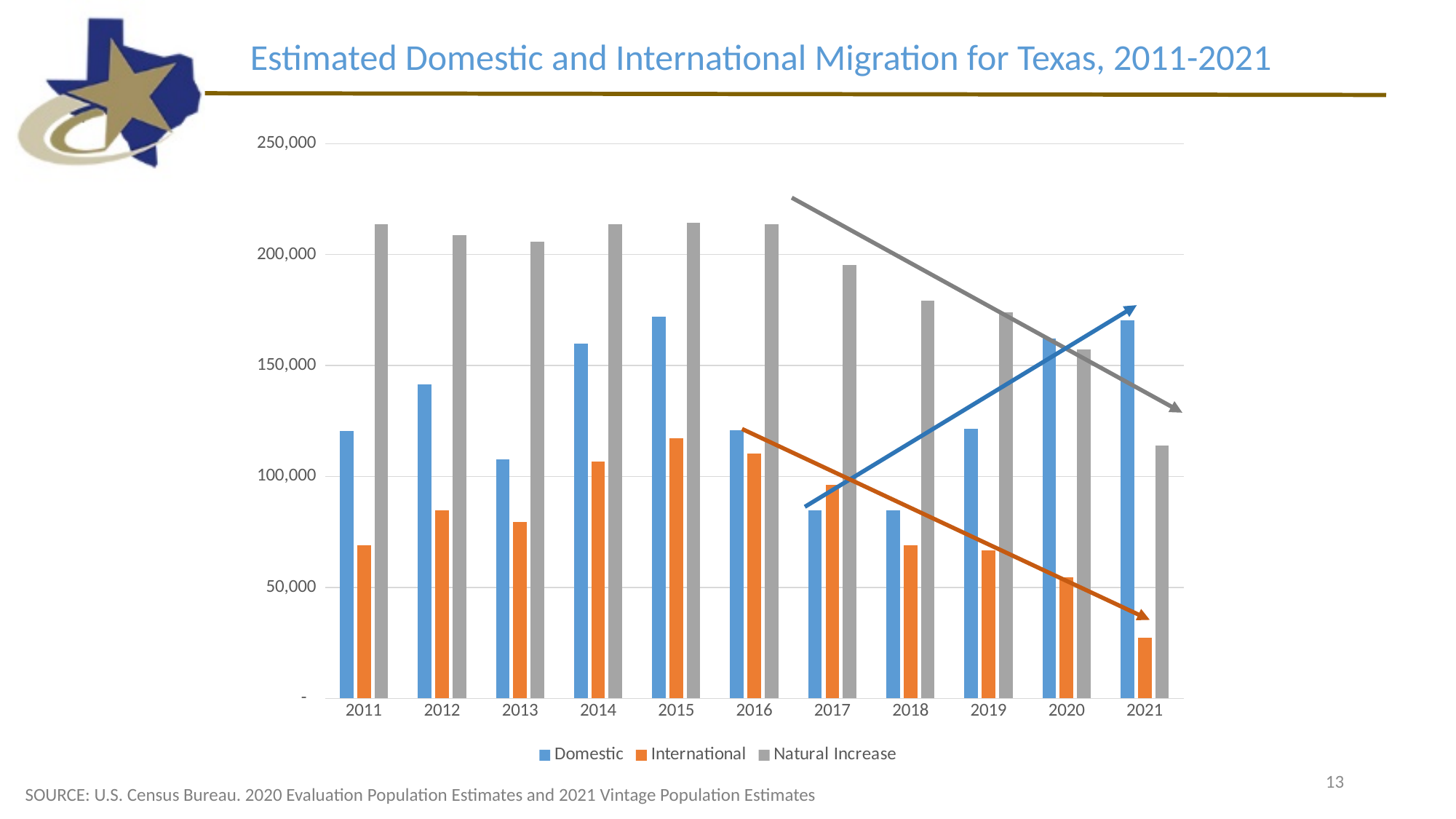
How many years are shown on the x axis? 11 What kind of chart is shown on the slide? Bar chart Does the International series rise or fall from 2015 to 2021? Fall In 2021, which is larger: Domestic or Natural Increase? Domestic Which year has the highest International value? 2015 Is the Domestic value for 2015 greater or less than 150,000? greater Is the Natural Increase value for 2011 greater or less than 200,000? greater Is the International value for 2021 greater or less than 50,000? less How many series does the legend list? 3 Which year has the lowest Natural Increase value? 2021 Which year has the lowest International value? 2021